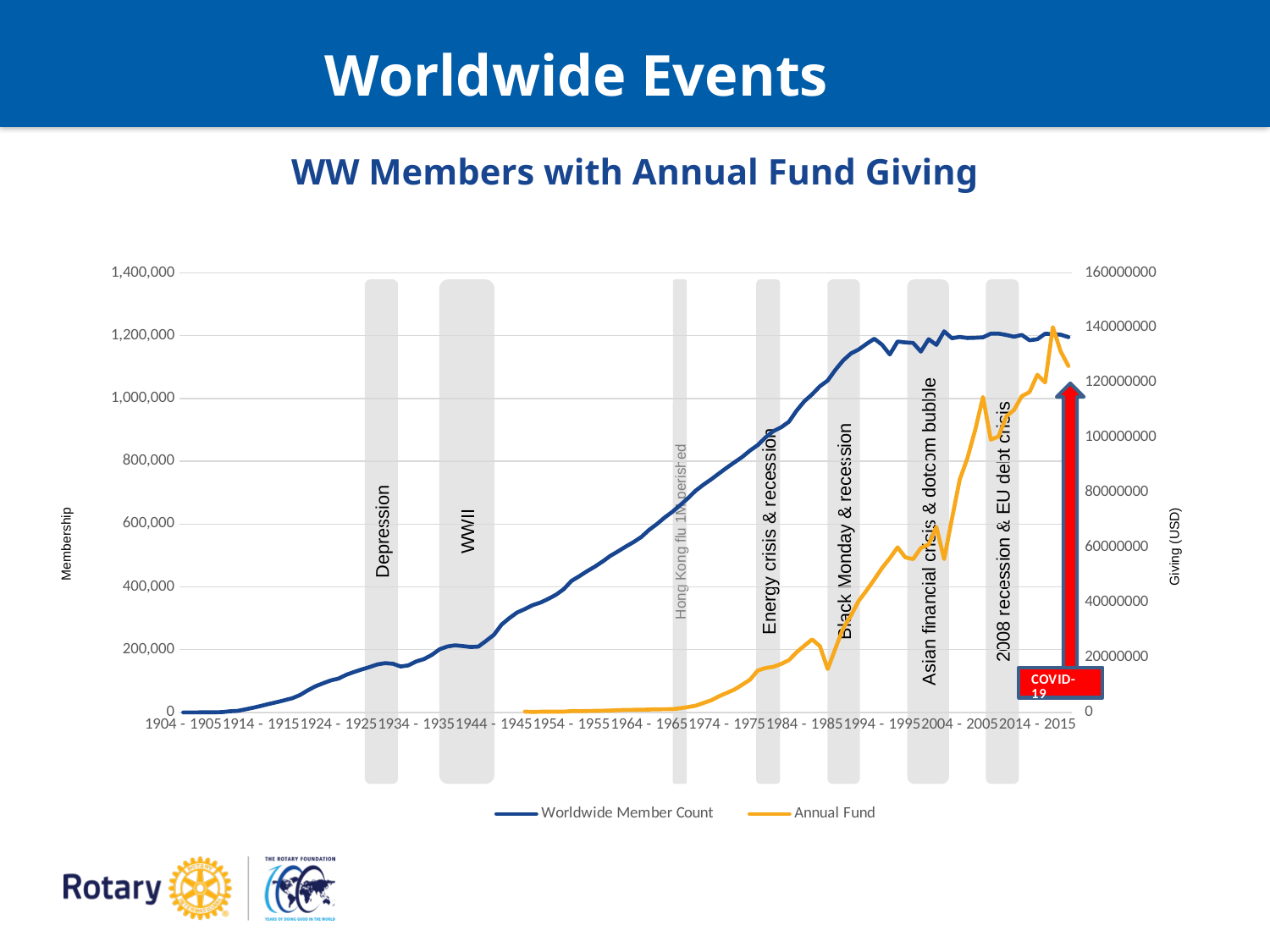
How many period labels are shown along the x axis? 12 How many series does the legend list? 2 What kind of chart is shown on the slide? Line chart Is the Worldwide Member Count for 2014 - 2015 greater or less than 1,000,000? greater Is the Worldwide Member Count for 1944 - 1945 greater or less than 400,000? less Is the Annual Fund value for 1984 - 1985 greater or less than 40000000? less What are the two series named in the legend? Worldwide Member Count and Annual Fund What is the title of the chart? WW Members with Annual Fund Giving Does the Annual Fund line generally rise or fall from 1944 - 1945 to 2014 - 2015? rise Does the Worldwide Member Count generally rise or fall from 1904 - 1905 to 1994 - 1995? rise